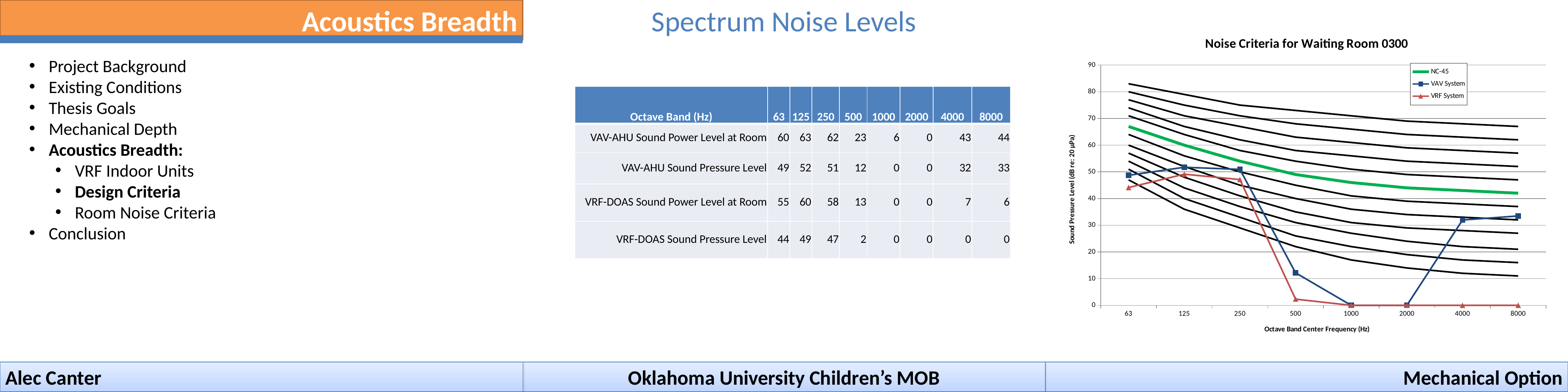
In the 'Noise Criteria for Waiting Room 0300' chart, what is the VRF System value at 4000 Hz? 0 In the 'Noise Criteria for Waiting Room 0300' chart, is the VRF System value at 500 Hz greater or less than 10? less How many series does the legend of the 'Noise Criteria for Waiting Room 0300' chart list? 3 How many octave band center frequencies are shown on the x axis of the 'Noise Criteria for Waiting Room 0300' chart? 8 What kind of chart is 'Noise Criteria for Waiting Room 0300'? line chart In the 'Noise Criteria for Waiting Room 0300' chart, is the VAV System value at 63 Hz greater or less than 40? greater In the 'Noise Criteria for Waiting Room 0300' chart, what colour is the NC-45 line? green What is the x-axis title of the 'Noise Criteria for Waiting Room 0300' chart? Octave Band Center Frequency (Hz) In the 'Noise Criteria for Waiting Room 0300' chart, is the NC-45 value at 63 Hz greater or less than 60? greater In the 'Noise Criteria for Waiting Room 0300' chart, what is the VAV System value at 1000 Hz? 0 In the 'Noise Criteria for Waiting Room 0300' chart, which series has the larger value at 4000 Hz, VAV System or VRF System? VAV System In the 'Noise Criteria for Waiting Room 0300' chart, does the VRF System line rise or fall between 250 Hz and 500 Hz? fall